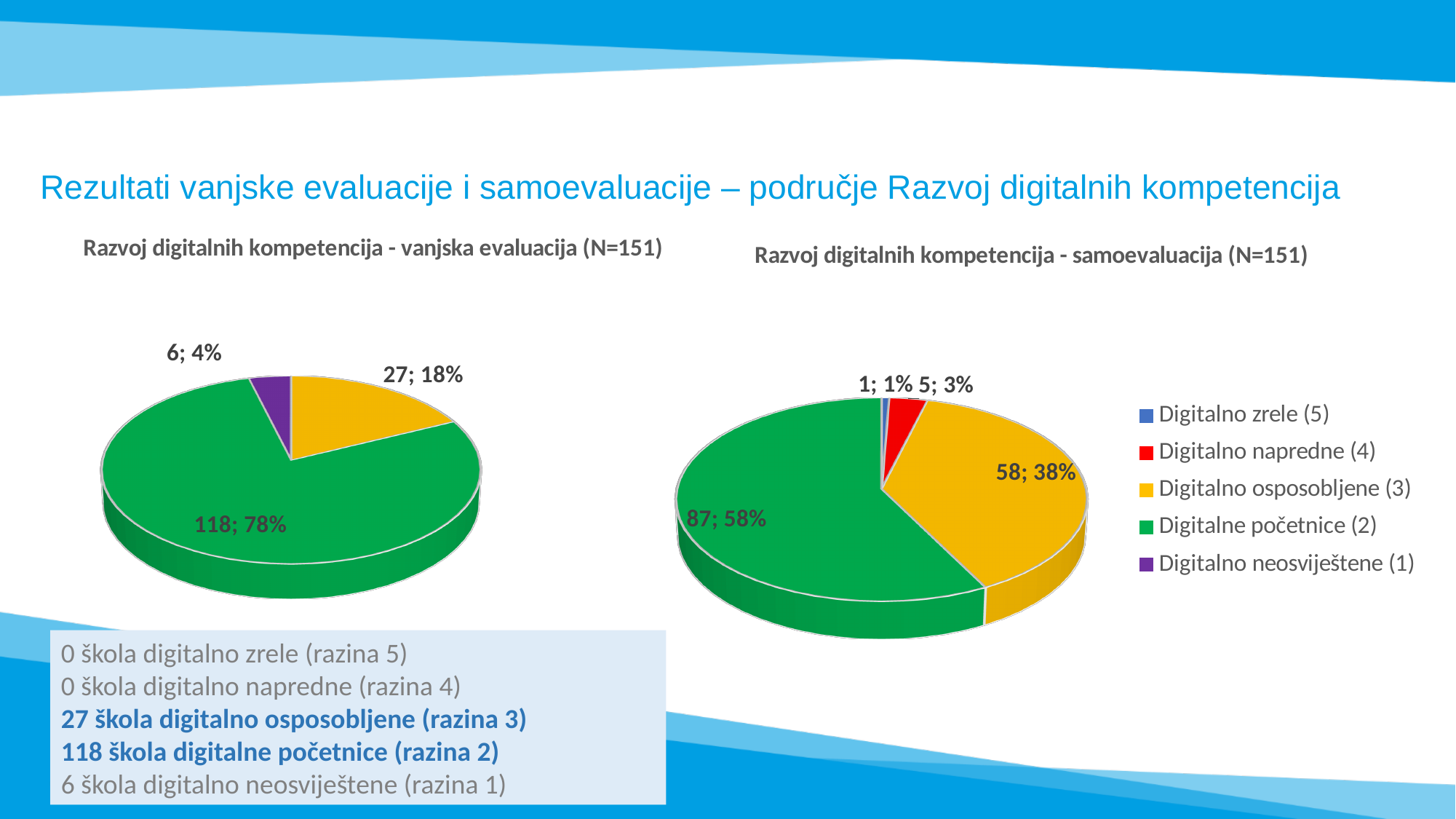
In the chart titled "Razvoj digitalnih kompetencija - samoevaluacija (N=151)", what percentage share does the Digitalne početnice (2) slice have? 58% In the chart titled "Razvoj digitalnih kompetencija - samoevaluacija (N=151)", what is the difference between the number of Digitalne početnice (2) schools and Digitalno osposobljene (3) schools? 29 Which chart has more Digitalno osposobljene (3) schools, the vanjska evaluacija chart or the samoevaluacija chart? samoevaluacija In the chart titled "Razvoj digitalnih kompetencija - samoevaluacija (N=151)", how many schools are Digitalno osposobljene (3)? 58 What type of chart is the chart titled "Razvoj digitalnih kompetencija - vanjska evaluacija (N=151)"? pie chart In the chart titled "Razvoj digitalnih kompetencija - samoevaluacija (N=151)", which category has the largest slice? Digitalne početnice (2) In the chart titled "Razvoj digitalnih kompetencija - vanjska evaluacija (N=151)", what percentage share does the Digitalno osposobljene (3) slice have? 18% In the chart titled "Razvoj digitalnih kompetencija - vanjska evaluacija (N=151)", which category has the smallest slice? Digitalno neosviještene (1) In the chart titled "Razvoj digitalnih kompetencija - vanjska evaluacija (N=151)", how many schools are Digitalne početnice (2)? 118 How many entries does the legend on the slide list? 5 In the chart titled "Razvoj digitalnih kompetencija - samoevaluacija (N=151)", how many schools are Digitalno napredne (4)? 5 How many slices does the chart titled "Razvoj digitalnih kompetencija - samoevaluacija (N=151)" have? 4